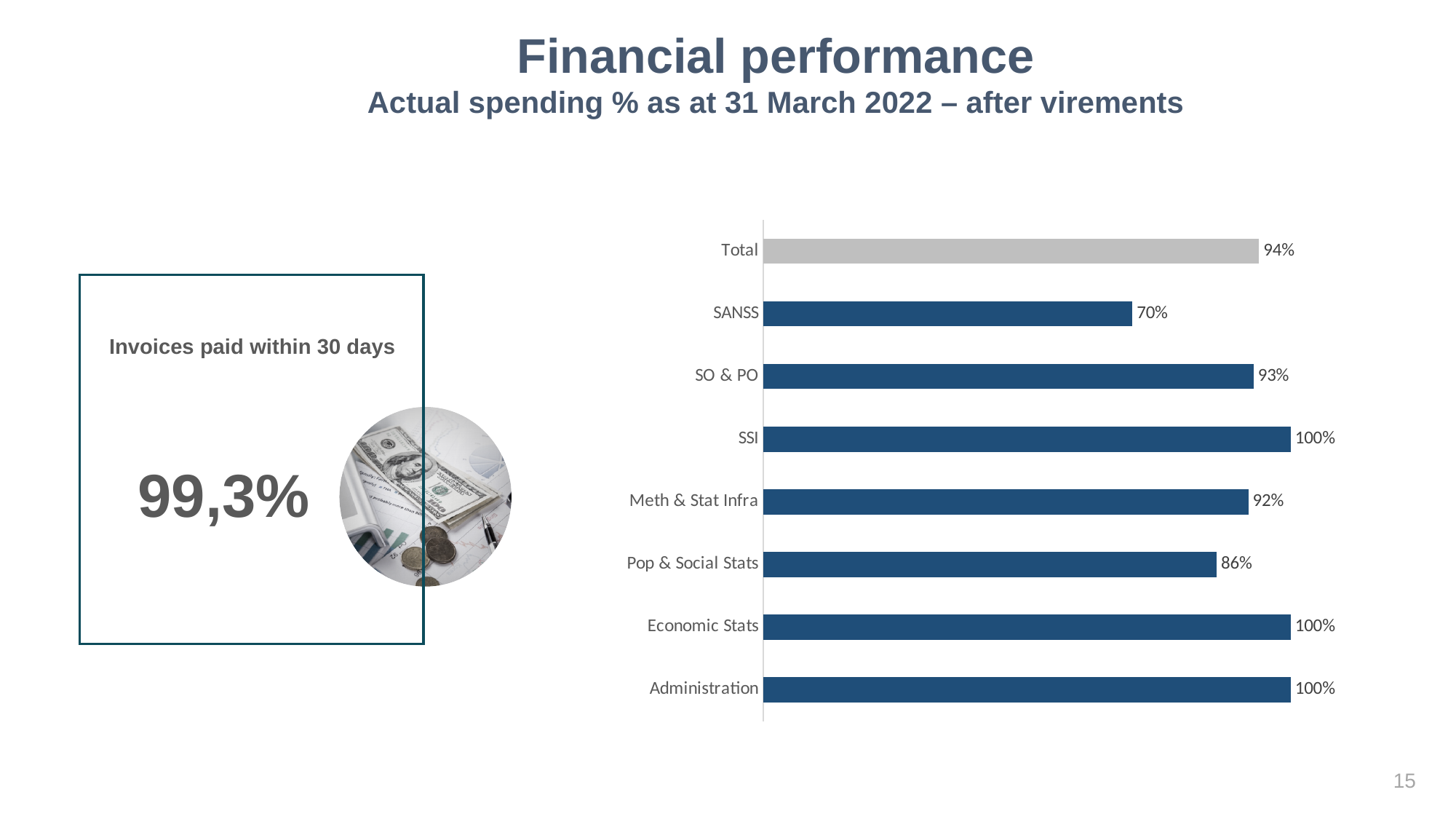
What is the actual spending percentage for Meth & Stat Infra? 92% What is the actual spending percentage for SANSS? 70% What is the actual spending percentage for SO & PO? 93% What is the difference between the spending percentage for SO & PO and SANSS? 23% Which bar in the chart is coloured grey rather than blue? Total What type of chart is used to show actual spending percentages? Bar chart How many categories reached 100% actual spending? 3 Which is larger, the spending percentage for Pop & Social Stats or Meth & Stat Infra? Meth & Stat Infra Which category has the lowest actual spending percentage? SANSS What is the Total actual spending percentage shown in the chart? 94% How many categories are shown in the bar chart? 8 What is the actual spending percentage for Pop & Social Stats? 86%